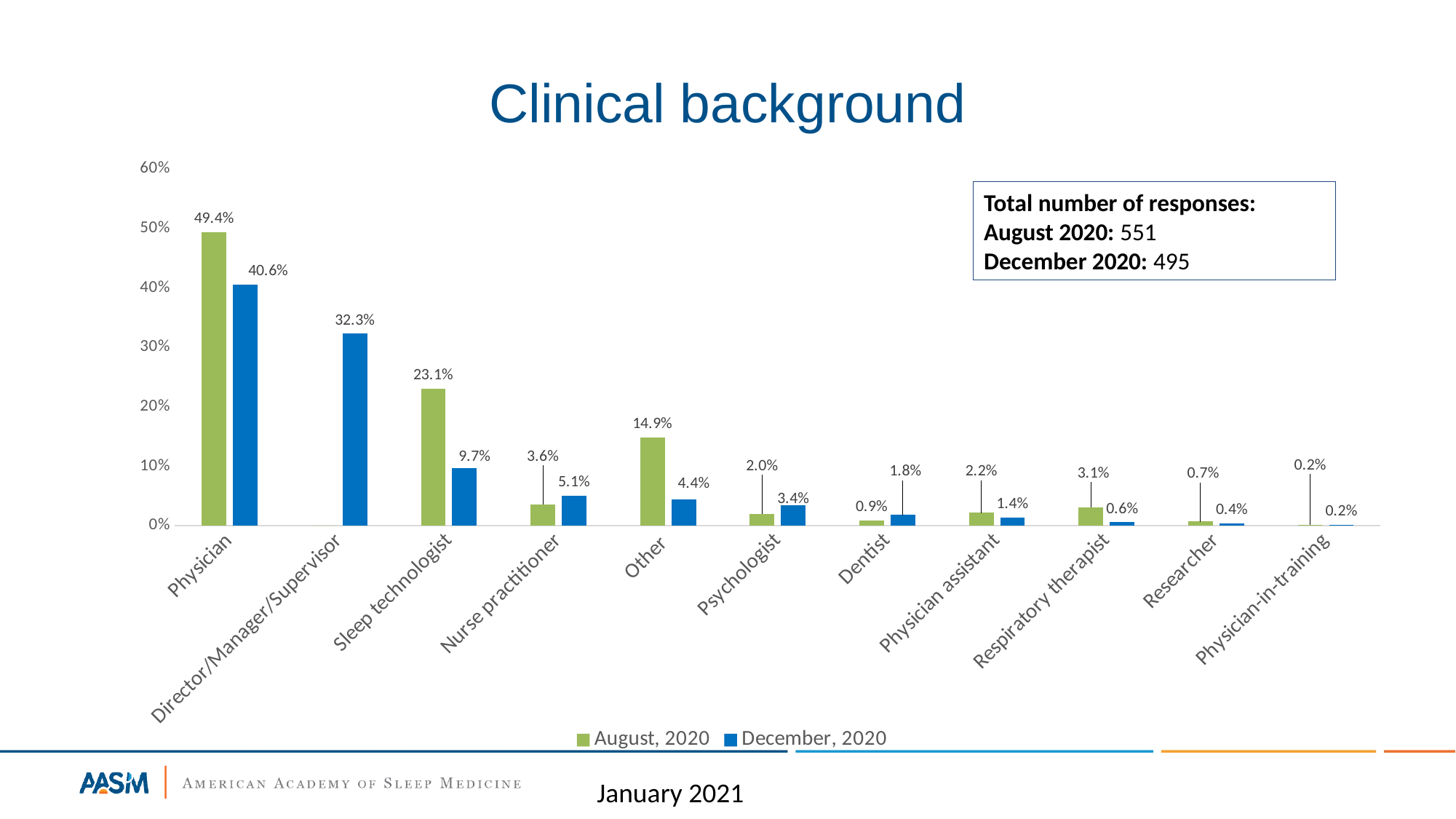
What is the August, 2020 value for Physician? 49.4% Which category has the highest December, 2020 value? Physician How many categories are shown on the x axis? 11 What kind of chart is shown on the slide? Bar chart What is the difference between the August, 2020 and December, 2020 values for Physician? 8.8% What is the December, 2020 value for Sleep technologist? 9.7% What is the December, 2020 value for Director/Manager/Supervisor? 32.3% Which category has the lowest August, 2020 value among those with a labelled bar? Physician-in-training What is the August, 2020 value for Other? 14.9% Which is larger for Nurse practitioner: the August, 2020 value or the December, 2020 value? December, 2020 How many series does the legend list? 2 Is the December, 2020 value for Director/Manager/Supervisor greater or less than 30%? greater